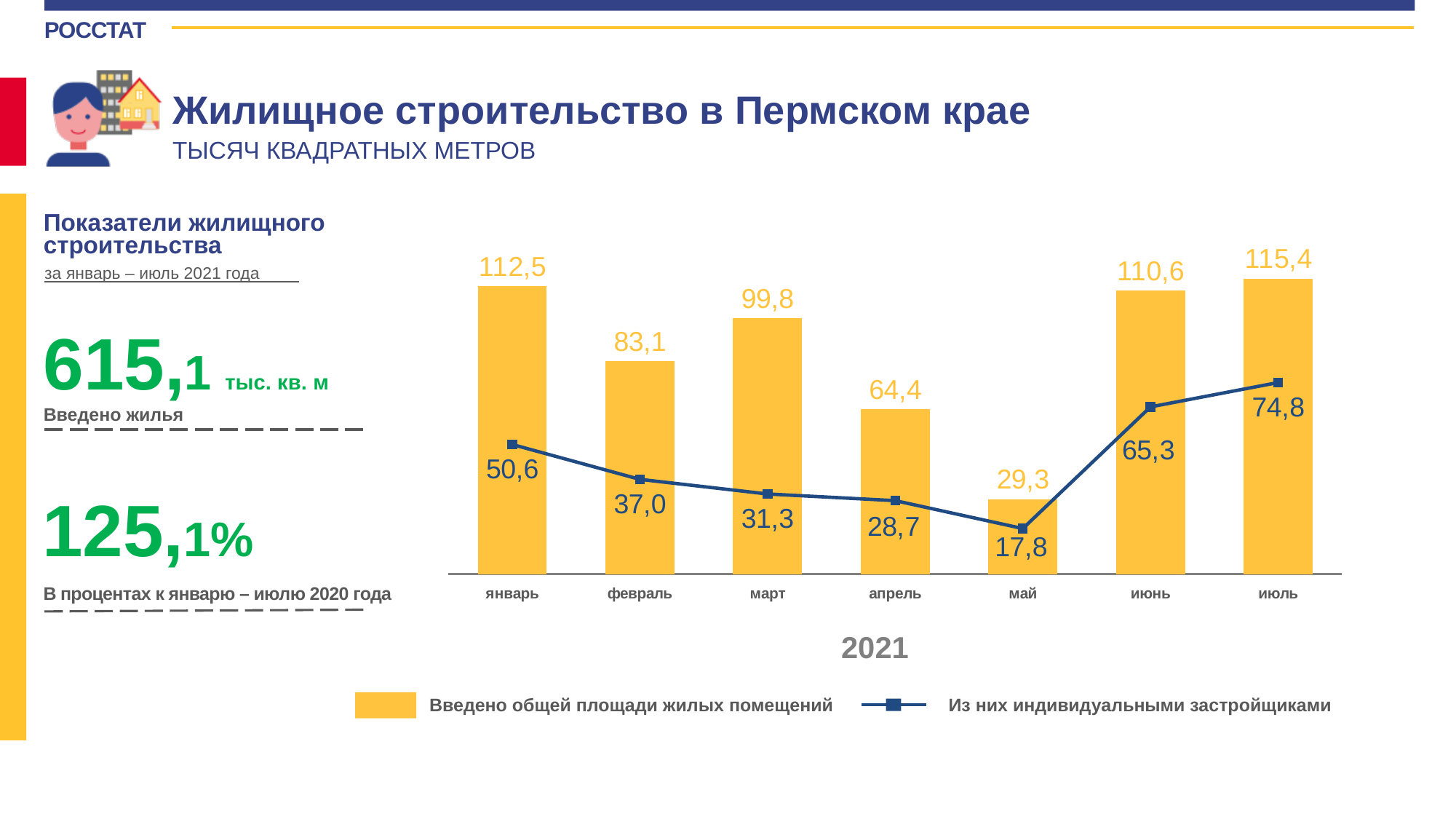
How many series does the chart legend list? 2 What kind of chart is shown on the slide? Combined bar and line chart What is the value of the bar for январь (Введено общей площади жилых помещений)? 112,5 Which is larger: the bar value for февраль or for март? март What is the value of the bar for апрель? 64,4 What is the value of the line series (Из них индивидуальными застройщиками) for май? 17,8 What is the difference between the bar values for июль and июнь? 4,8 How many months are shown on the x axis of the chart? 7 Which month has the highest bar value for Введено общей площади жилых помещений? июль Which month has the lowest value for Из них индивидуальными застройщиками? май What year is shown below the x axis of the chart? 2021 Does the line series Из них индивидуальными застройщиками rise or fall from январь to май? fall